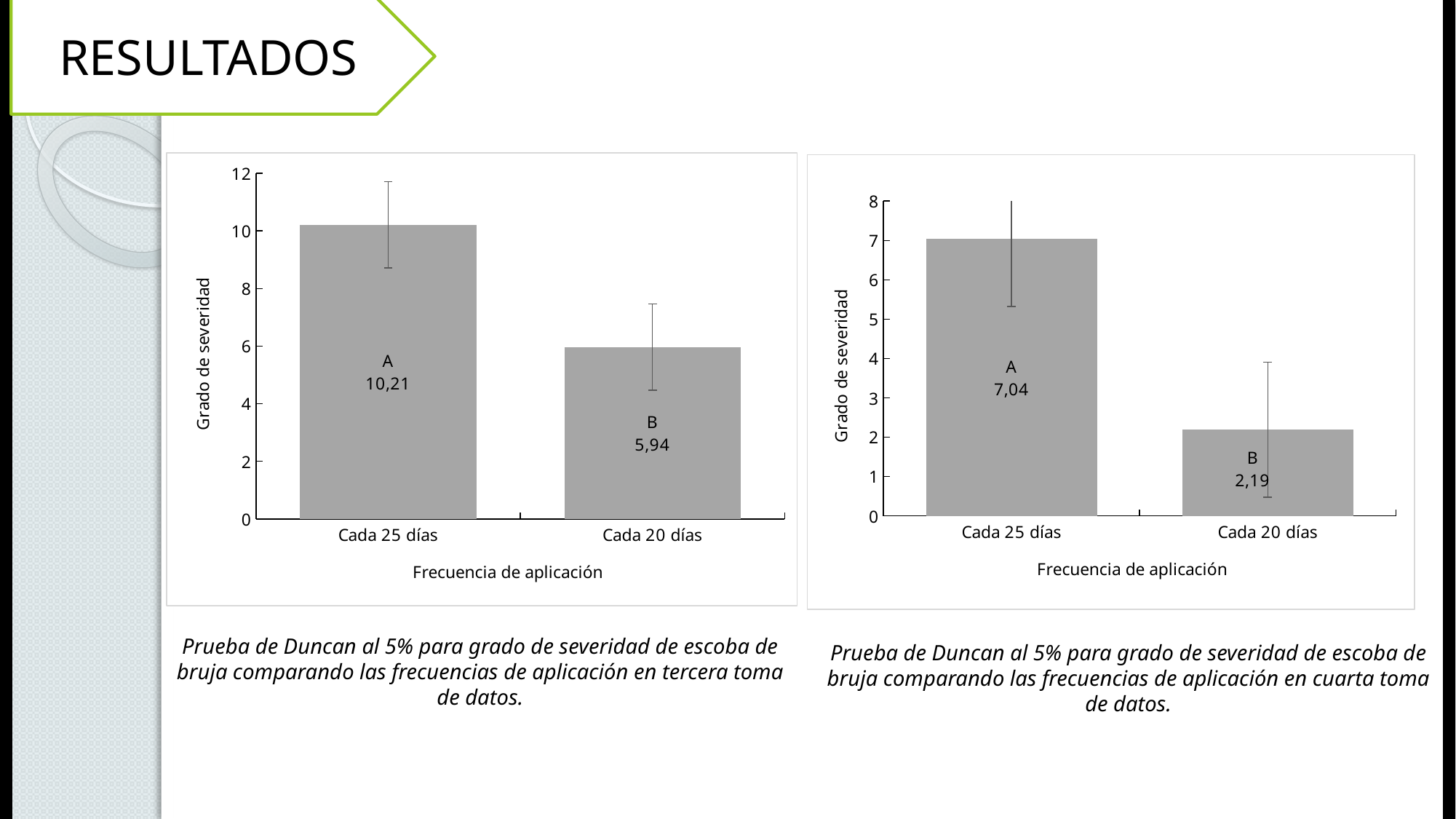
What kind of chart is the right chart (cuarta toma de datos)? Bar chart In the right chart (cuarta toma de datos), what is the value for Cada 20 días? 2,19 In the right chart (cuarta toma de datos), what is the value for Cada 25 días? 7,04 In the left chart (tercera toma de datos), what is the value for Cada 20 días? 5,94 In the left chart (tercera toma de datos), which application frequency has the highest grado de severidad? Cada 25 días In the right chart (cuarta toma de datos), is the value for Cada 25 días greater or less than 6? greater In the left chart (tercera toma de datos), what is the difference between the values for Cada 25 días and Cada 20 días? 4,27 In the right chart (cuarta toma de datos), which application frequency has the lowest grado de severidad? Cada 20 días What is the y-axis label of the left chart (tercera toma de datos)? Grado de severidad How many categories are shown on the x axis of the left chart (tercera toma de datos)? 2 In the left chart (tercera toma de datos), what is the value for Cada 25 días? 10,21 In the right chart (cuarta toma de datos), what is the difference between the values for Cada 25 días and Cada 20 días? 4,85